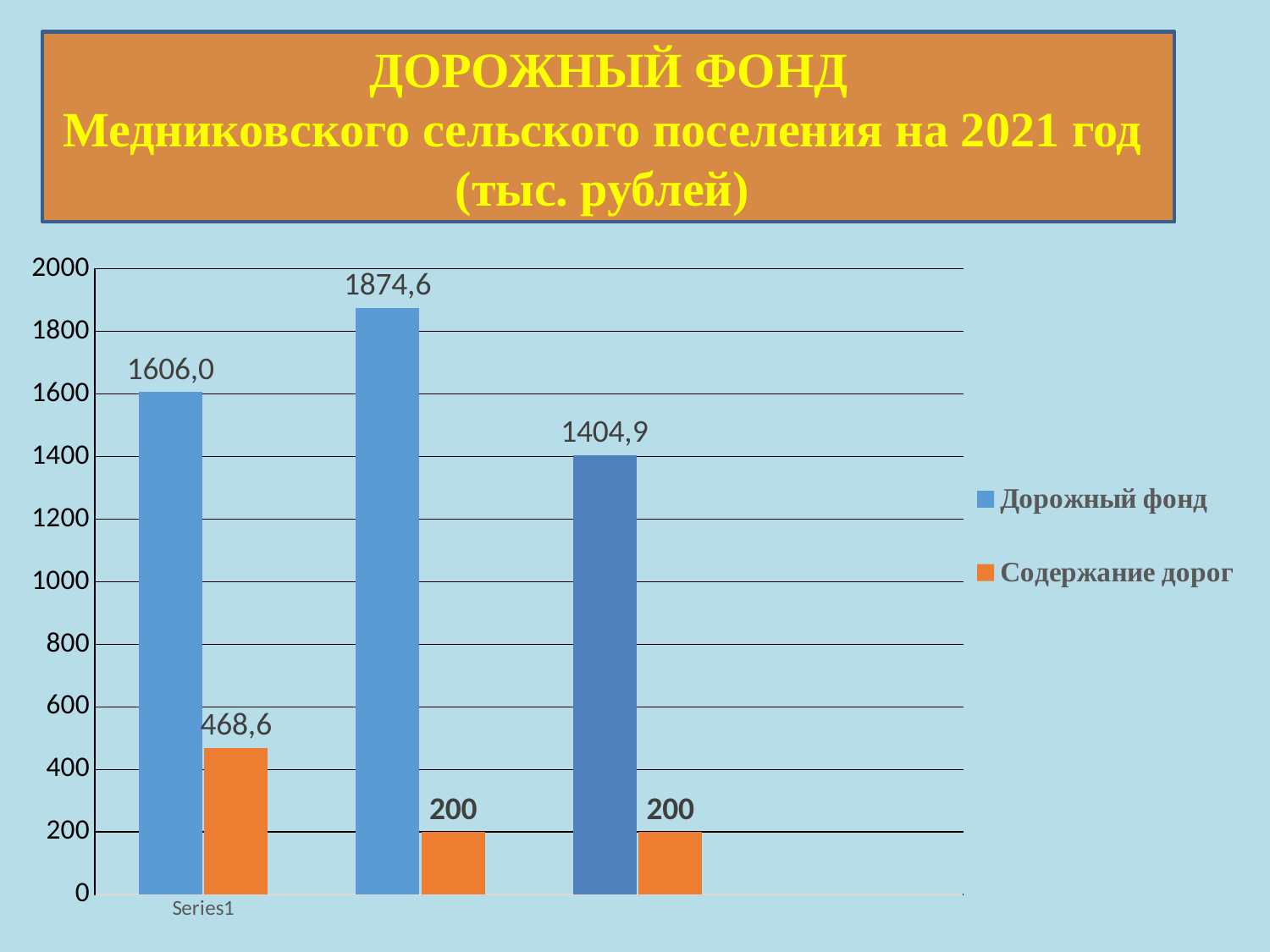
How many series does the legend list? 2 What is the highest value shown for the Дорожный фонд series? 1874,6 How many groups of bars are plotted in the chart? 3 What is the lowest value shown for the Дорожный фонд series? 1404,9 What kind of chart is shown on the slide? Bar chart What colour represents the Содержание дорог series in the legend? Orange What is the value of the Дорожный фонд bar in the group labelled Series1? 1606,0 What is the value of the Содержание дорог bar in the group labelled Series1? 468,6 What is the difference between the highest Дорожный фонд value (1874,6) and the lowest Дорожный фонд value (1404,9)? 469,7 In the group labelled Series1, which is larger: the Дорожный фонд bar or the Содержание дорог bar? Дорожный фонд What is the value of the Дорожный фонд bar in the second group of bars from the left? 1874,6 Is the value of the Дорожный фонд bar in the third group of bars greater or less than 1600? less